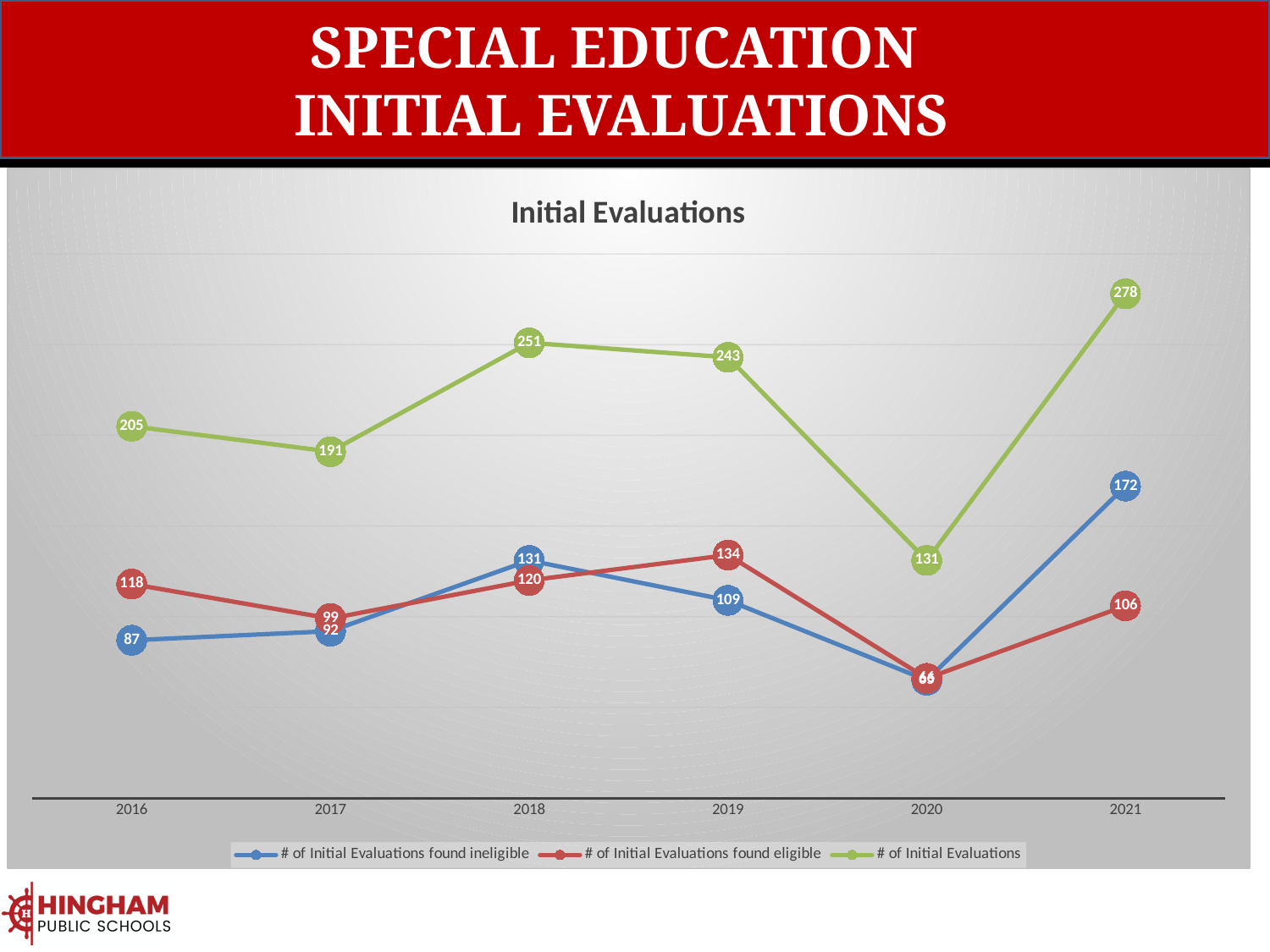
In which year was the # of Initial Evaluations highest? 2021 In 2018, were more Initial Evaluations found ineligible or eligible? Ineligible How many series does the legend list? 3 What kind of chart is shown on the slide? Line chart How many years are shown on the x axis? 6 How many Initial Evaluations were found ineligible in 2021? 172 By how much did the # of Initial Evaluations increase from 2020 to 2021? 147 What is the difference between the # of Initial Evaluations found eligible in 2016 and in 2017? 19 In which year was the # of Initial Evaluations lowest? 2020 What is the # of Initial Evaluations in 2018? 251 Did the # of Initial Evaluations rise or fall from 2016 to 2017? Fall How many Initial Evaluations were found eligible in 2019? 134